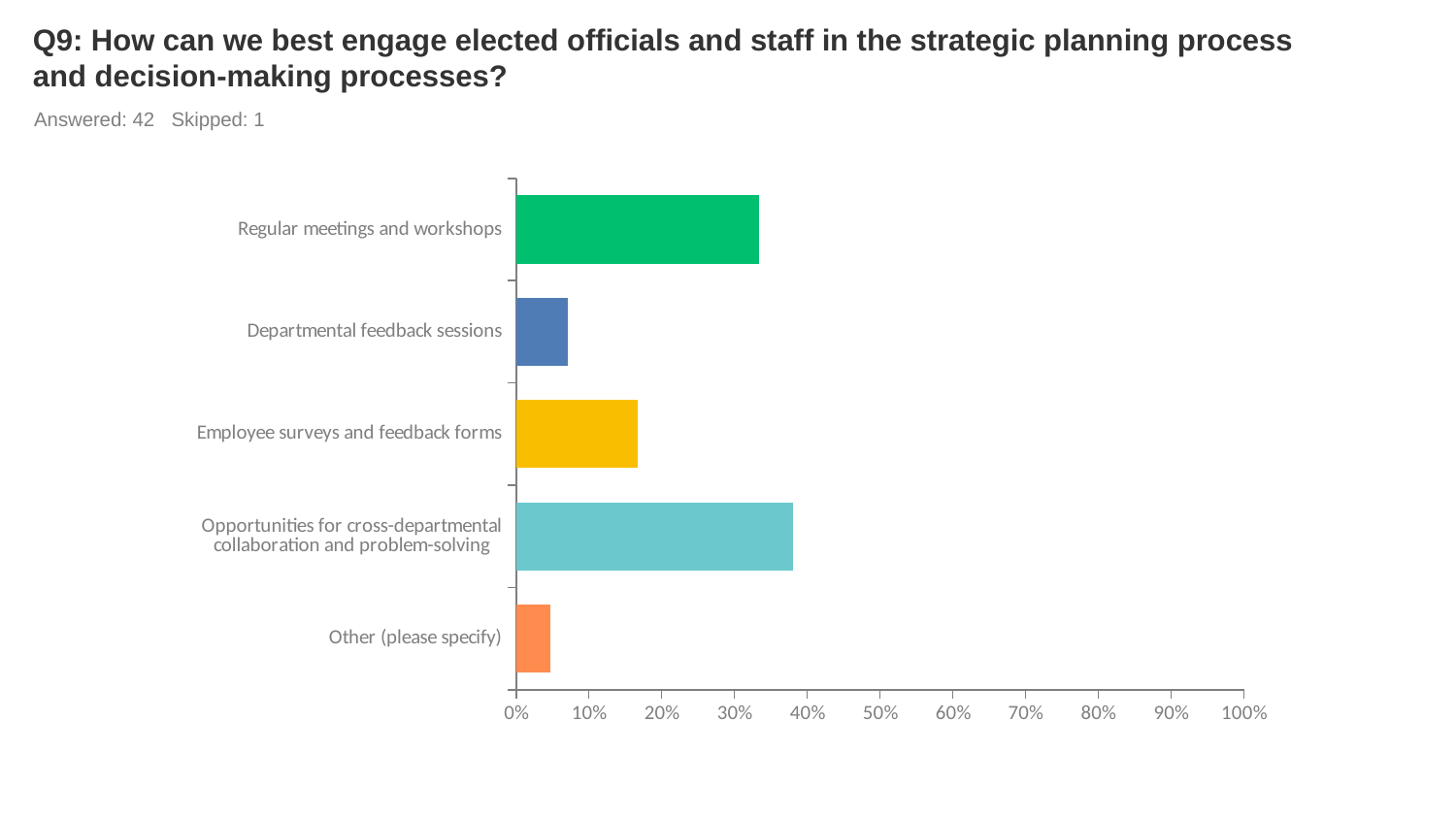
Is the value for Other (please specify) greater or less than 10%? less How many respondents answered the question shown on the slide? 42 What is the highest value shown on the horizontal axis of the chart? 100% Which is larger: the value for Departmental feedback sessions or the value for Employee surveys and feedback forms? Employee surveys and feedback forms Is the value for Regular meetings and workshops greater or less than 30%? greater How many categories are plotted in the chart? 5 Is the value for Employee surveys and feedback forms greater or less than 10%? greater What kind of chart is shown on the slide? bar chart Which is larger: the value for Regular meetings and workshops or the value for Employee surveys and feedback forms? Regular meetings and workshops Which category has the highest value in the chart? Opportunities for cross-departmental collaboration and problem-solving